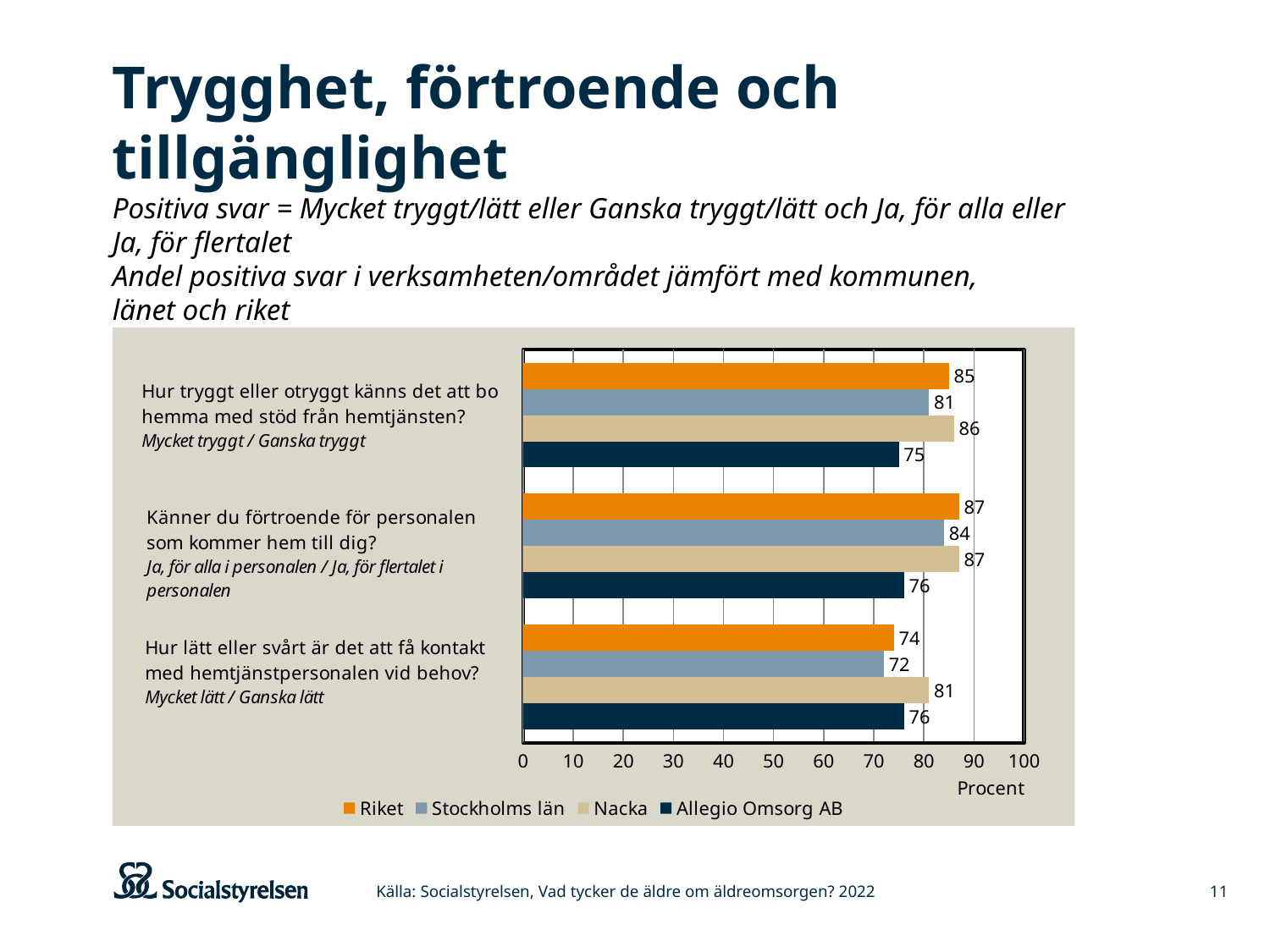
What is the value for Allegio Omsorg AB on the question "Hur tryggt eller otryggt känns det att bo hemma med stöd från hemtjänsten?"? 75 How many question categories are shown on the chart? 3 Which series has the lowest value on the question "Känner du förtroende för personalen som kommer hem till dig?"? Allegio Omsorg AB What is the value for Stockholms län on the question "Känner du förtroende för personalen som kommer hem till dig?"? 84 What kind of chart is shown on the slide? Bar chart What is the value for Nacka on the question "Hur lätt eller svårt är det att få kontakt med hemtjänstpersonalen vid behov?"? 81 How many series does the legend list? 4 Which is larger on the question "Hur lätt eller svårt är det att få kontakt med hemtjänstpersonalen vid behov?": Riket or Allegio Omsorg AB? Allegio Omsorg AB Which series has the highest value on the question "Hur lätt eller svårt är det att få kontakt med hemtjänstpersonalen vid behov?"? Nacka What is the difference between Nacka and Allegio Omsorg AB on the question "Hur tryggt eller otryggt känns det att bo hemma med stöd från hemtjänsten?"? 11 Is the value for Riket on the question "Känner du förtroende för personalen som kommer hem till dig?" greater or less than 80? greater What is the label on the horizontal axis of the chart? Procent